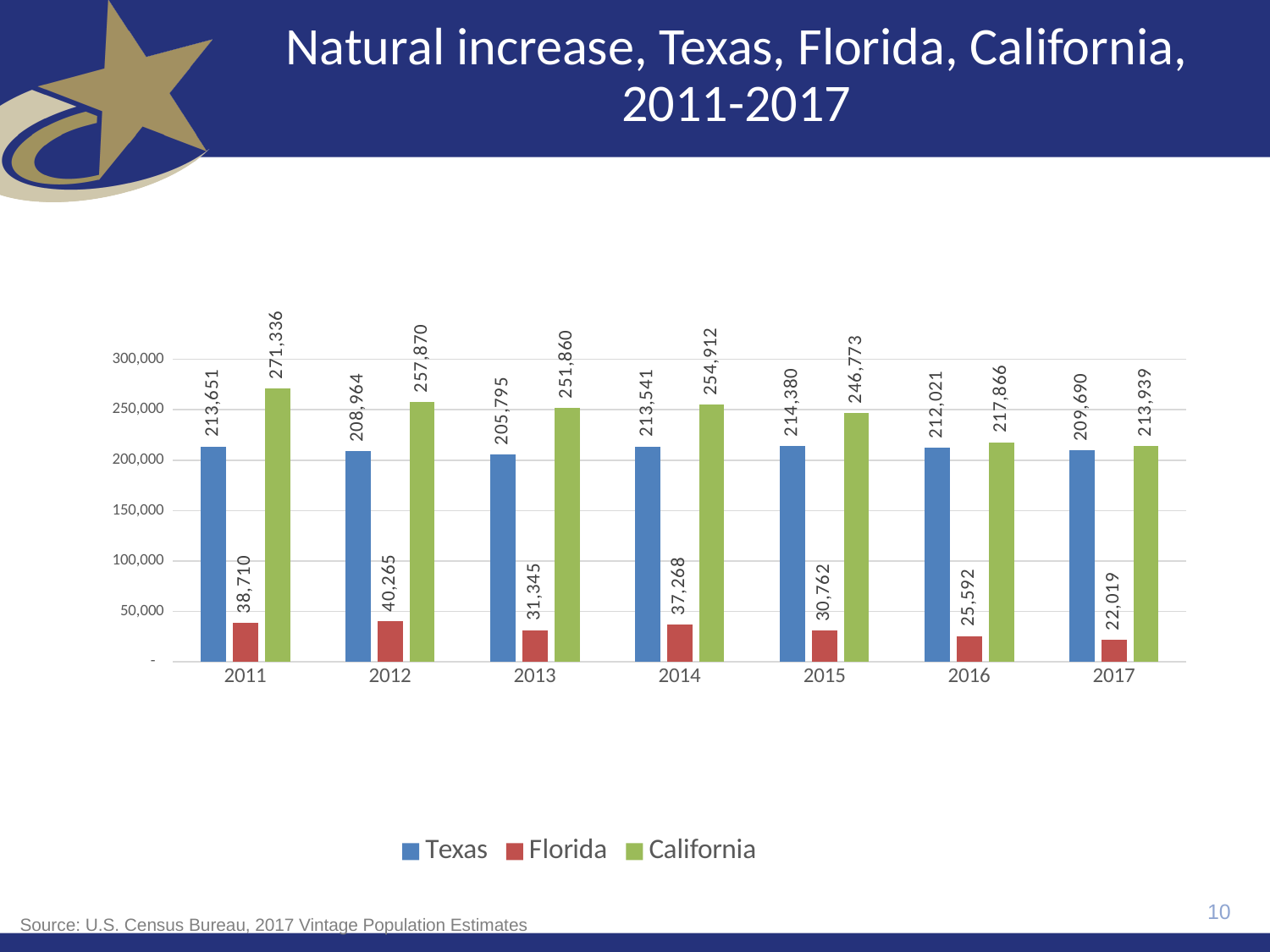
What is the natural increase for Texas in 2011? 213,651 How many years are shown on the x axis? 7 Which is larger in 2012: Texas's natural increase or California's? California What is the difference between California's and Texas's natural increase in 2017? 4,249 Does California's natural increase rise or fall from 2011 to 2017? Fall What kind of chart is shown on the slide? Bar chart In which year is Florida's natural increase lowest? 2017 What is the natural increase for Florida in 2017? 22,019 How many series does the legend list? 3 Is the value for Florida in 2012 greater or less than 50,000? less What is the natural increase for California in 2014? 254,912 In which year is California's natural increase highest? 2011